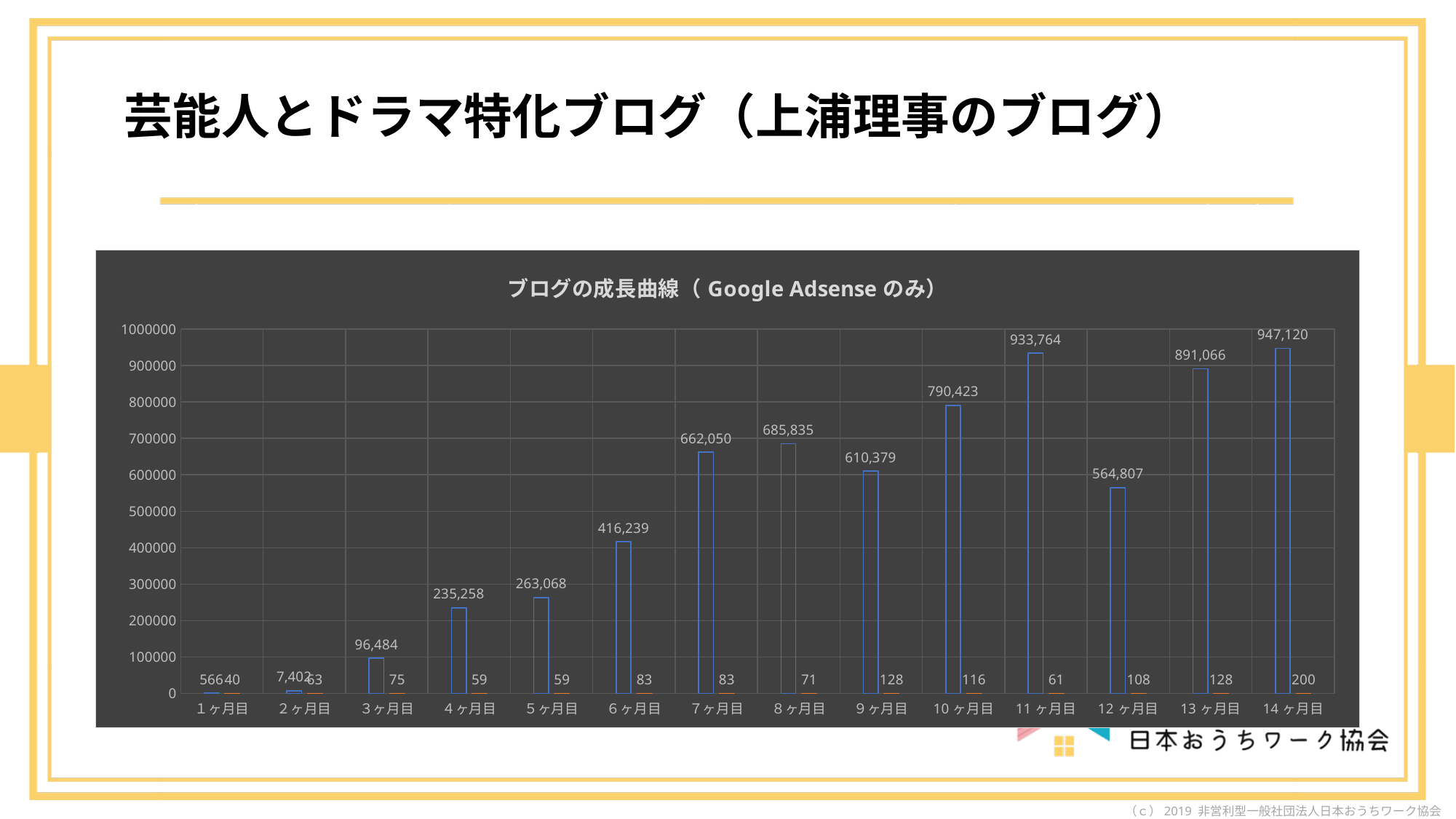
What is the value of the tall blue bar for 12 ヶ月目? 564,807 Which is larger, the blue bar value for 9 ヶ月目 or for 10 ヶ月目? 10 ヶ月目 What is the difference between the blue bar values for 8 ヶ月目 and 7 ヶ月目? 23,785 What kind of chart is shown on the slide? bar chart What is the value of the tall blue bar for 7 ヶ月目? 662,050 How many months (categories) are shown on the x axis? 14 What is the title of the chart? ブログの成長曲線（ Google Adsense のみ） Is the blue bar value for 12 ヶ月目 greater or less than 500000? greater What is the small value labelled next to the 14 ヶ月目 bar? 200 What is the difference between the blue bar values for 14 ヶ月目 and 11 ヶ月目? 13,356 Which month has the highest blue bar value? 14 ヶ月目 What is the value of the tall blue bar for 14 ヶ月目? 947,120